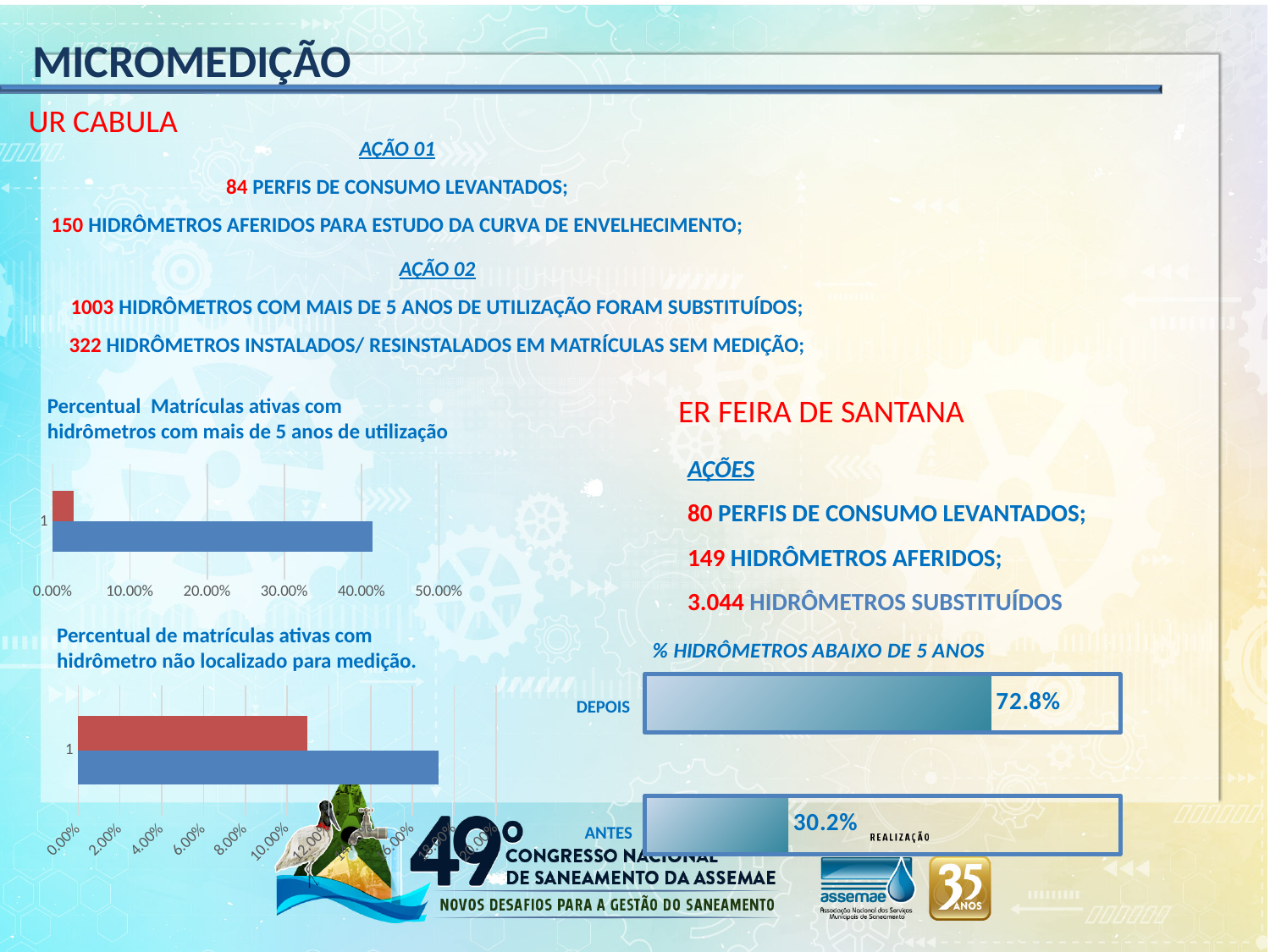
In the '% HIDRÔMETROS ABAIXO DE 5 ANOS' chart, what is the value for ANTES? 30.2% In the chart 'Percentual Matrículas ativas com hidrômetros com mais de 5 anos de utilização', is the value of the blue bar greater or less than 30.00%? greater In the chart 'Percentual de matrículas ativas com hidrômetro não localizado para medição', is the value of the blue bar greater or less than 16.00%? greater What is the highest axis tick shown on the chart 'Percentual Matrículas ativas com hidrômetros com mais de 5 anos de utilização'? 50.00% In the '% HIDRÔMETROS ABAIXO DE 5 ANOS' chart, what is the difference between DEPOIS and ANTES? 42.6% In the '% HIDRÔMETROS ABAIXO DE 5 ANOS' chart, how many bars are shown? 2 In the chart 'Percentual de matrículas ativas com hidrômetro não localizado para medição', is the value of the red bar greater or less than 8.00%? greater In the '% HIDRÔMETROS ABAIXO DE 5 ANOS' chart, what is the value for DEPOIS? 72.8% What kind of chart is 'Percentual Matrículas ativas com hidrômetros com mais de 5 anos de utilização'? bar chart In the chart 'Percentual Matrículas ativas com hidrômetros com mais de 5 anos de utilização', which bar is longer, the red one or the blue one? the blue one In the '% HIDRÔMETROS ABAIXO DE 5 ANOS' chart, which is larger, ANTES or DEPOIS? DEPOIS